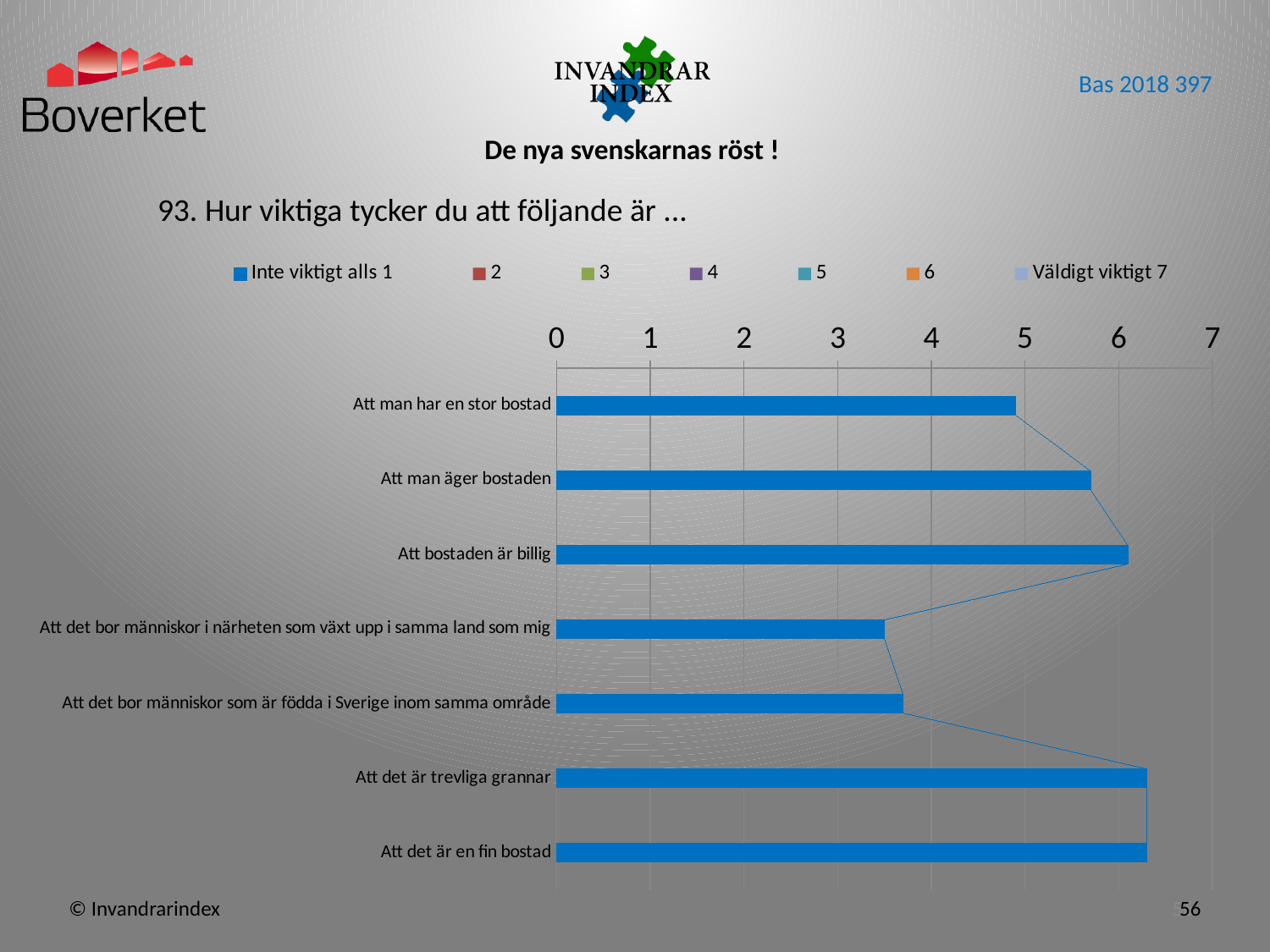
Is the value for "Att man äger bostaden" greater or less than 5? greater Which has the larger value: "Att man äger bostaden" or "Att man har en stor bostad"? Att man äger bostaden How many categories are plotted in the chart? 7 Is the value for "Att man har en stor bostad" greater or less than 4? greater Is the value for "Att det bor människor i närheten som växt upp i samma land som mig" greater or less than 4? less What kind of chart is shown on the slide? bar chart How many series does the legend list? 7 Which has the larger value: "Att bostaden är billig" or "Att det bor människor som är födda i Sverige inom samma område"? Att bostaden är billig What is the first entry in the chart's legend? Inte viktigt alls 1 What is the question text shown as the chart's heading? 93. Hur viktiga tycker du att följande är ...